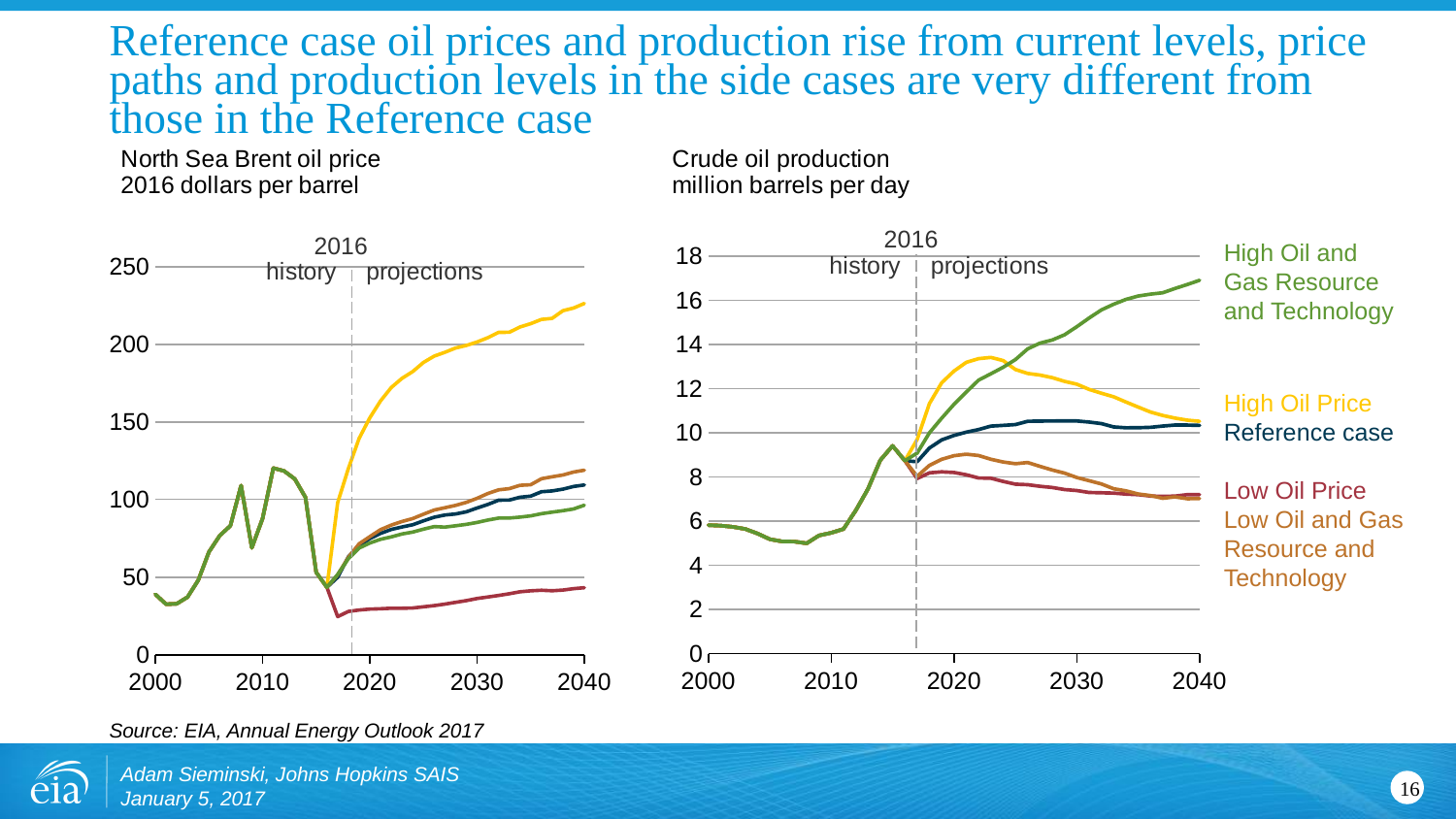
In the Crude oil production chart, is the High Oil and Gas Resource and Technology value in 2040 greater or less than 16? greater What kind of chart is the North Sea Brent oil price chart on the left? line chart In the North Sea Brent oil price chart, which case has the highest price in 2040? High Oil Price How many cases does the legend on the right list for the crude oil production chart? 5 In the North Sea Brent oil price chart, is the Low Oil Price value in 2040 greater or less than 50? less In the Crude oil production chart, is the Low Oil Price value in 2040 greater or less than 8? less In the Crude oil production chart, which is larger in 2040: the High Oil and Gas Resource and Technology case or the Reference case? High Oil and Gas Resource and Technology In the Crude oil production chart, which case has the highest production in 2040? High Oil and Gas Resource and Technology What unit is used on the Crude oil production chart? million barrels per day In the North Sea Brent oil price chart, which case has the lowest price in 2040? Low Oil Price In the North Sea Brent oil price chart, does the High Oil Price line rise or fall over the projection period from 2020 to 2040? rise